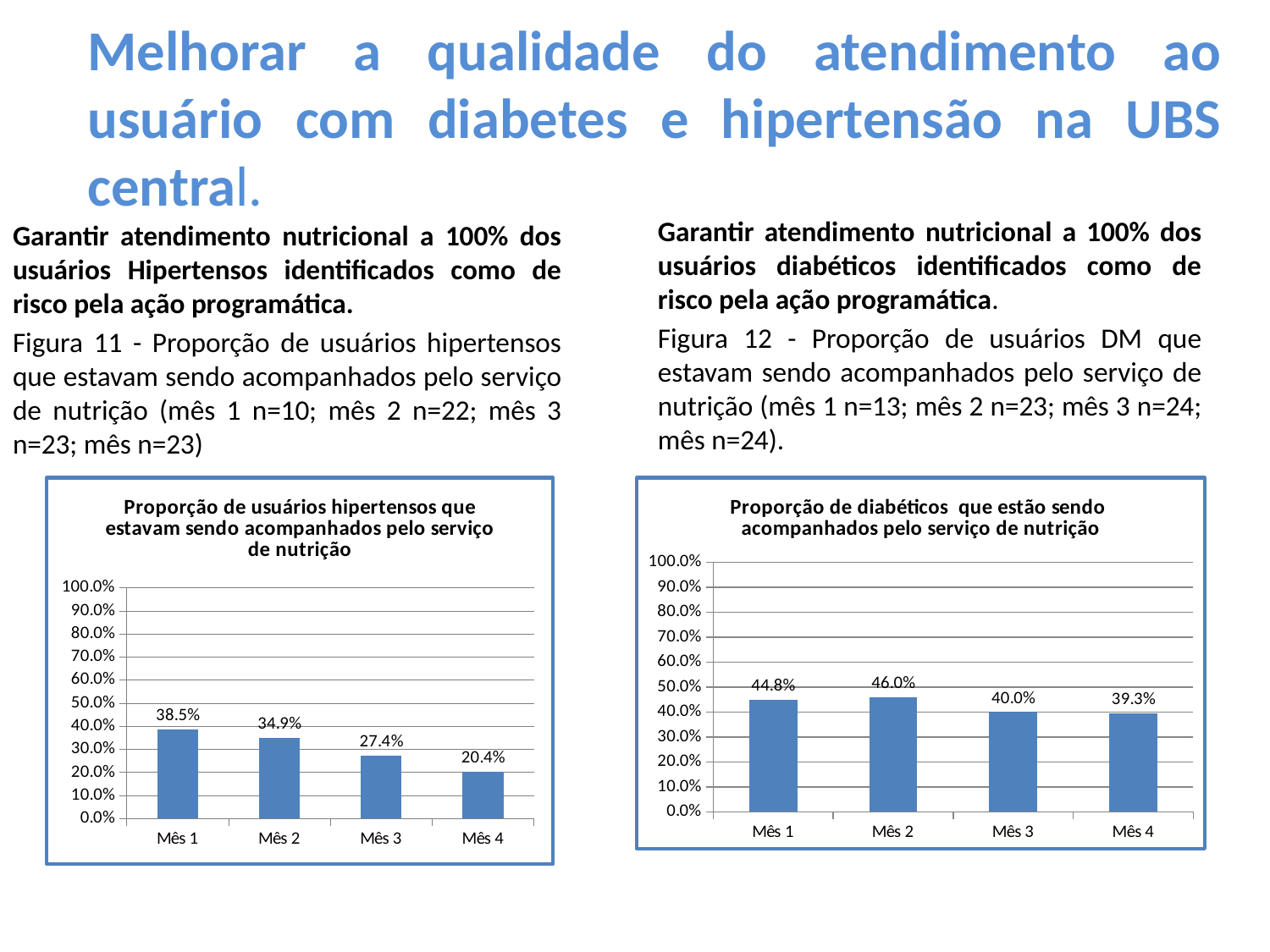
How many months (categories) are shown in the left chart (Proporção de usuários hipertensos)? 4 In the right chart (Proporção de diabéticos que estão sendo acompanhados pelo serviço de nutrição), what is the value for Mês 2? 46.0% In the right chart (Proporção de diabéticos), what is the value for Mês 3? 40.0% In the left chart (Proporção de usuários hipertensos), what is the difference between Mês 1 and Mês 4? 18.1% In the right chart (Proporção de diabéticos), which month has the lowest value? Mês 4 In the left chart (Proporção de usuários hipertensos que estavam sendo acompanhados pelo serviço de nutrição), what is the value for Mês 1? 38.5% What type of chart is the right chart (Proporção de diabéticos)? bar chart In the left chart (Proporção de usuários hipertensos), do the values rise or fall from Mês 1 to Mês 4? fall In the left chart (Proporção de usuários hipertensos), which month has the highest value? Mês 1 In the right chart (Proporção de diabéticos), which is larger, the value for Mês 1 or Mês 3? Mês 1 In the left chart (Proporção de usuários hipertensos), what is the value for Mês 4? 20.4% In the right chart (Proporção de diabéticos), what is the difference between Mês 2 and Mês 4? 6.7%